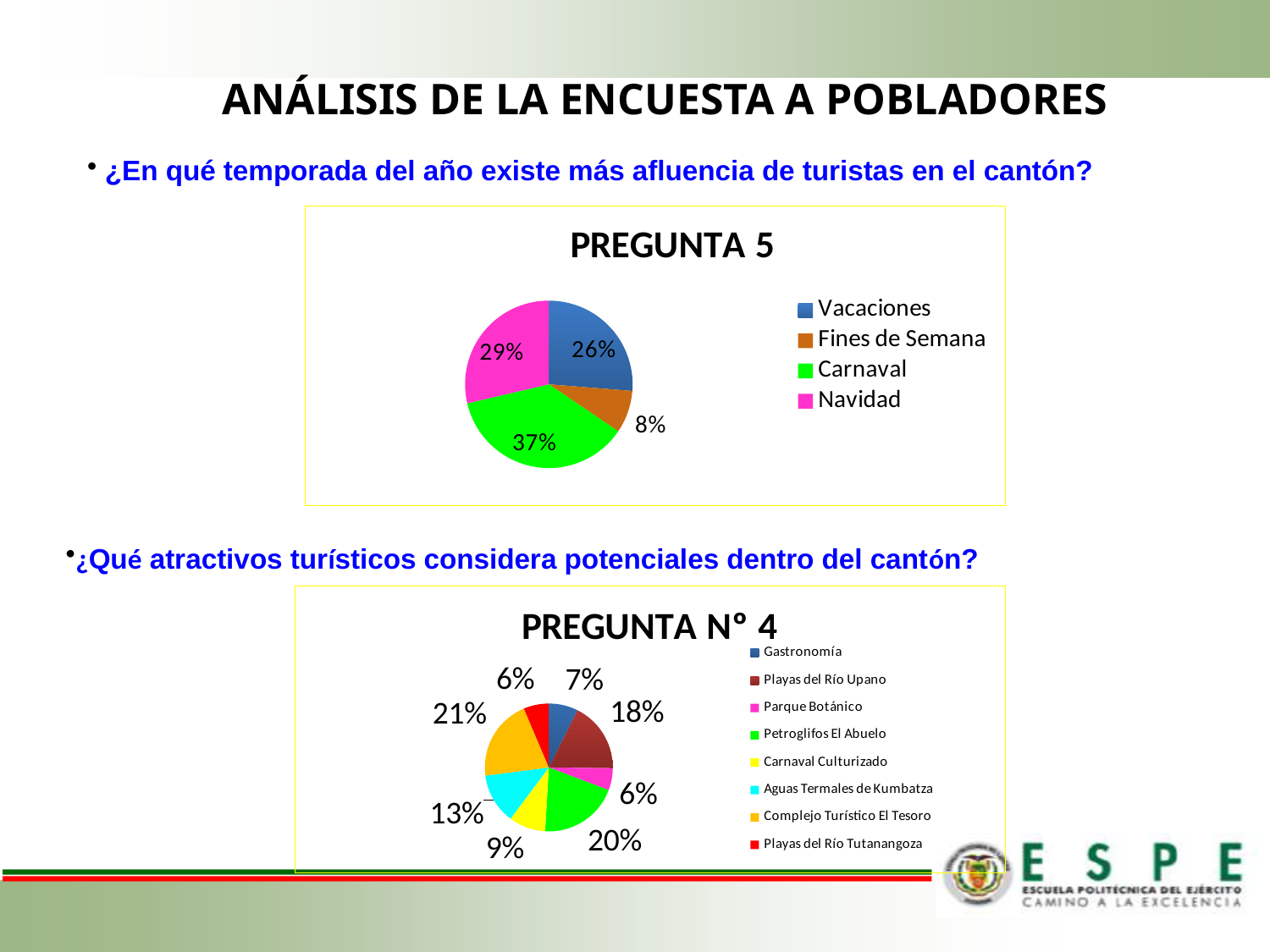
In the PREGUNTA 5 chart, how many categories does the legend list? 4 In the PREGUNTA 5 chart, which category has the smallest slice? Fines de Semana In the PREGUNTA 5 chart, which category has the largest slice? Carnaval In the PREGUNTA Nº 4 chart, what is the difference between the Complejo Turístico El Tesoro and Carnaval Culturizado shares? 12% In the PREGUNTA 5 chart, what share does Carnaval have? 37% In the PREGUNTA Nº 4 chart, how many categories does the legend list? 8 In the PREGUNTA Nº 4 chart, which is larger, Playas del Río Upano or Petroglifos El Abuelo? Petroglifos El Abuelo In the PREGUNTA Nº 4 chart, what share does Aguas Termales de Kumbatza have? 13% In the PREGUNTA 5 chart, what share does Fines de Semana have? 8% What type of chart is the PREGUNTA Nº 4 chart? Pie chart In the PREGUNTA 5 chart, what is the difference between the Navidad and Vacaciones shares? 3% In the PREGUNTA Nº 4 chart, what share does Complejo Turístico El Tesoro have? 21%